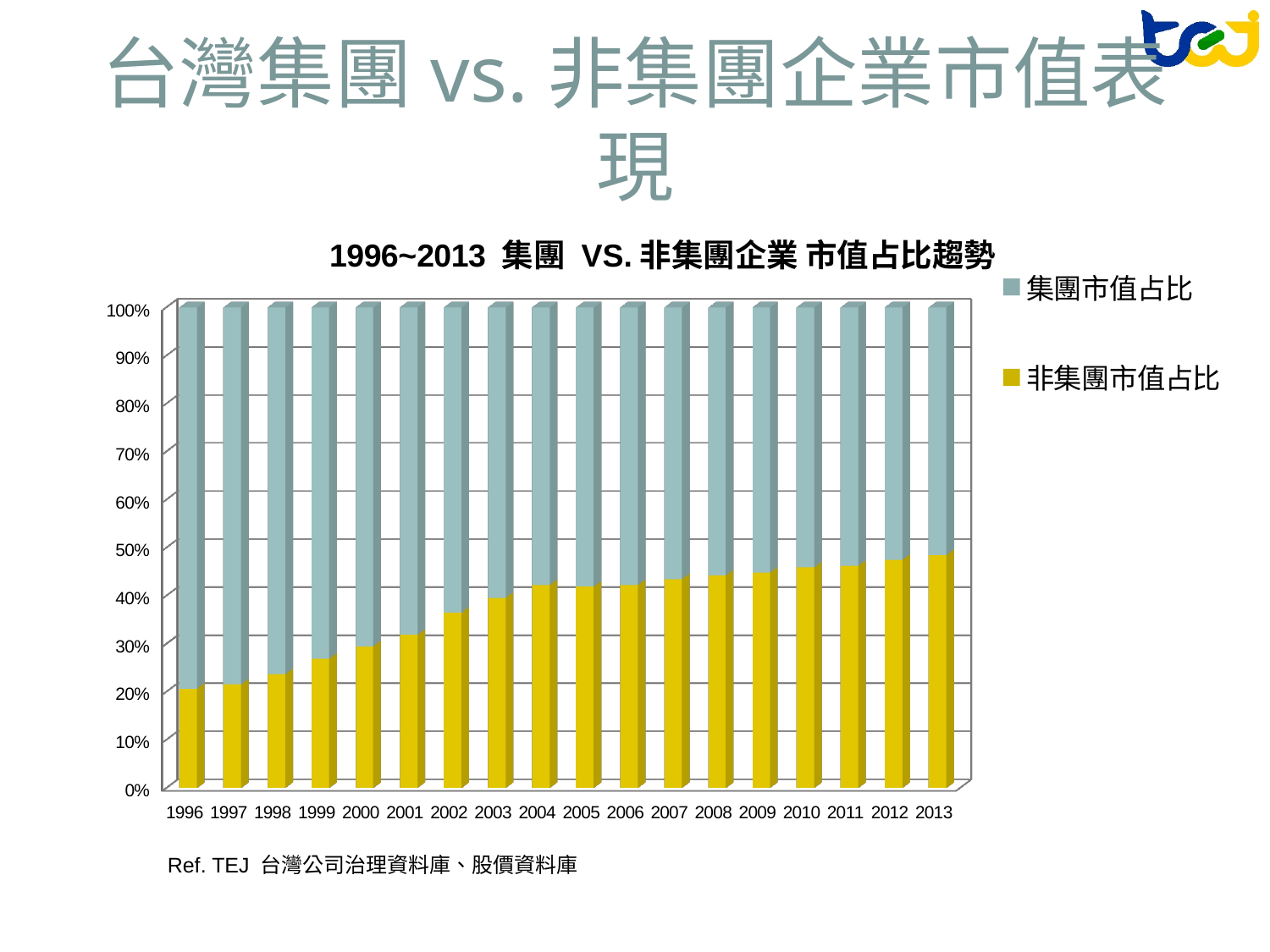
Which series is shown in yellow in the chart? 非集團市值占比 In which year is the 集團市值占比 share the highest? 1996 Is the 非集團市值占比 value for 1996 greater or less than 30%? less How many years are shown along the x axis of the chart? 18 In 1996, which is larger: 集團市值占比 or 非集團市值占比? 集團市值占比 Is the 非集團市值占比 value for 2013 greater or less than 40%? greater In which year is the 非集團市值占比 share the highest? 2013 What kind of chart is shown on the slide? stacked bar chart In which year is the 非集團市值占比 share the lowest? 1996 What is the title of the chart? 1996~2013 集團 VS. 非集團企業 市值占比趨勢 How many series does the chart legend list? 2 Does the 非集團市值占比 share rise or fall from 1996 to 2013? rise